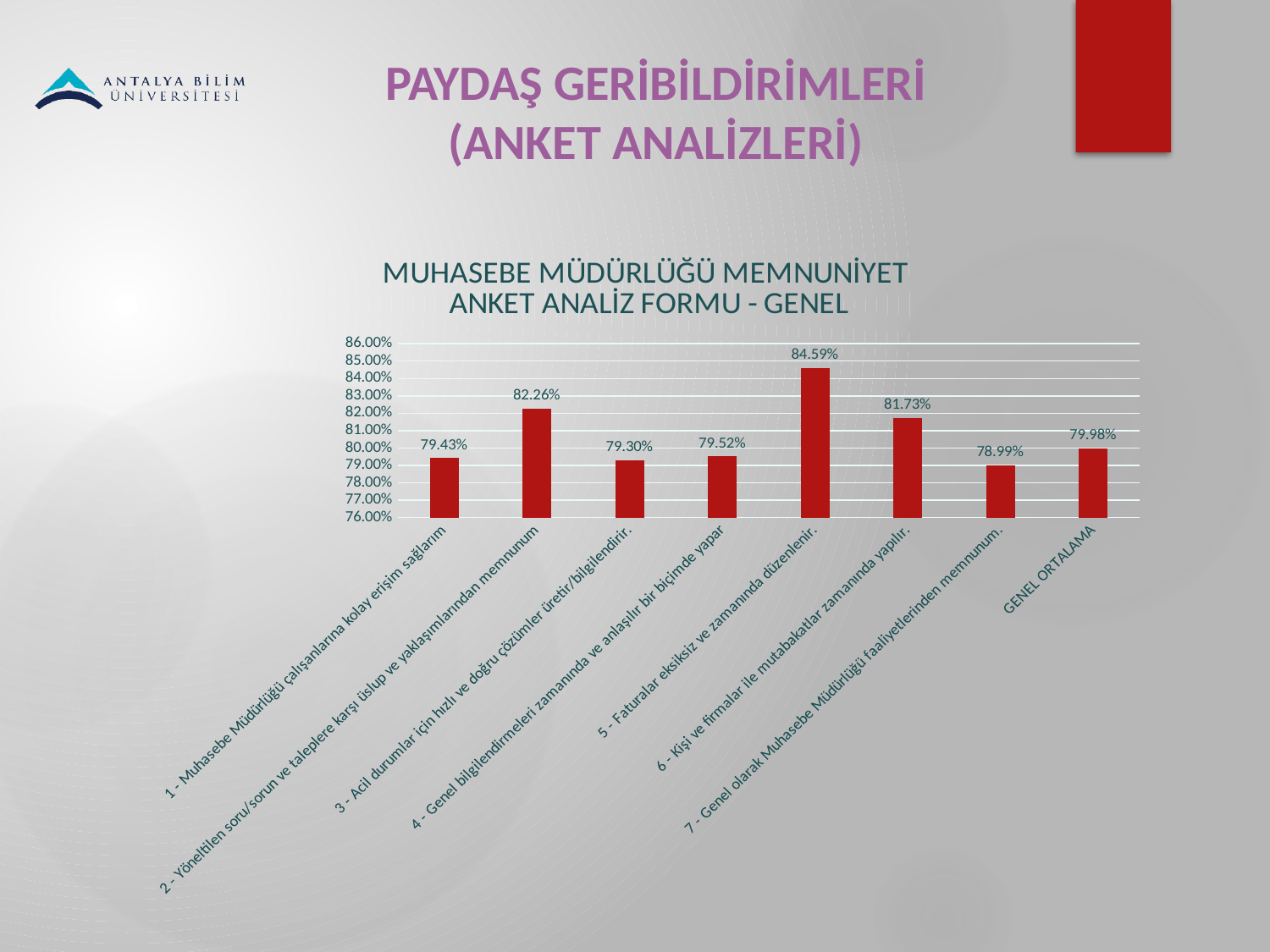
Which is larger: the value for item 2 (üslup ve yaklaşımlarından memnunum) or item 6 (mutabakatlar zamanında yapılır)? Item 2 (82.26%) What is the value for "2 - Yöneltilen soru/sorun ve taleplere karşı üslup ve yaklaşımlarından memnunum"? 82.26% Is the value for "6 - Kişi ve firmalar ile mutabakatlar zamanında yapılır." greater or less than 80.00%? greater Which category has the highest value? 5 - Faturalar eksiksiz ve zamanında düzenlenir. What is the difference between the highest value (84.59%) and the lowest value (78.99%)? 5.60% Which category has the lowest value? 7 - Genel olarak Muhasebe Müdürlüğü faaliyetlerinden memnunum. What is the value for "7 - Genel olarak Muhasebe Müdürlüğü faaliyetlerinden memnunum."? 78.99% What is the title of the chart? MUHASEBE MÜDÜRLÜĞÜ MEMNUNİYET ANKET ANALİZ FORMU - GENEL What kind of chart is shown on the slide? Bar chart What is the value shown for GENEL ORTALAMA? 79.98% How many bars are shown in the chart? 8 What is the value for "5 - Faturalar eksiksiz ve zamanında düzenlenir."? 84.59%